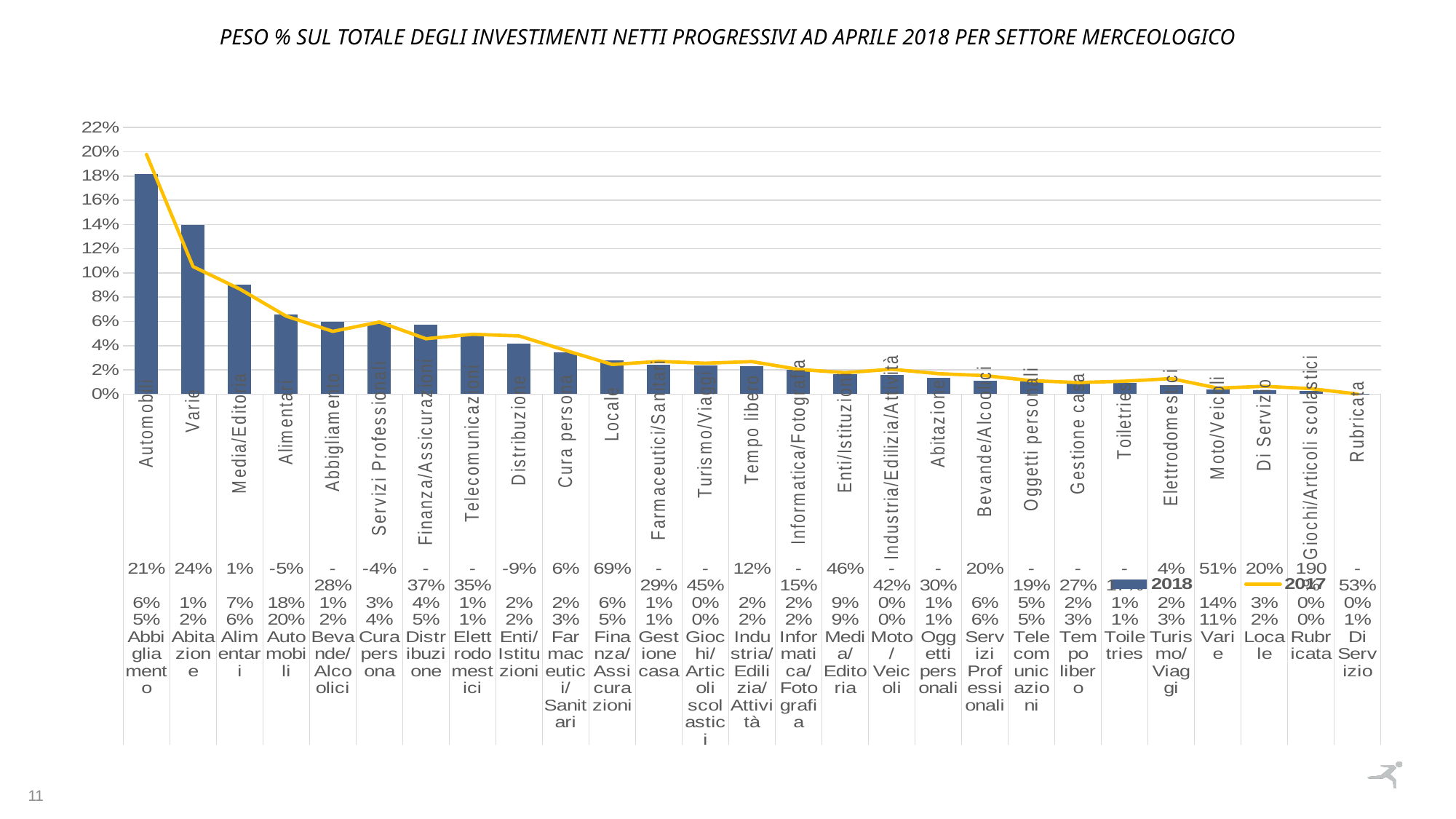
Is the 2018 value for Varie greater or less than 12%? greater Which sector has the highest 2018 bar? Automobili Is the 2018 value for Distribuzione greater or less than 6%? less Which has the larger 2018 bar, Automobili or Varie? Automobili What kind of chart is shown on the slide? bar chart with a line How many series does the legend list? 2 Is the 2018 value for Automobili greater or less than 16%? greater Do the 2018 bar values rise or fall from left to right along the x axis? fall How many sectors are shown on the x axis? 27 Which has the larger 2018 bar, Media/Editoria or Alimentari? Media/Editoria